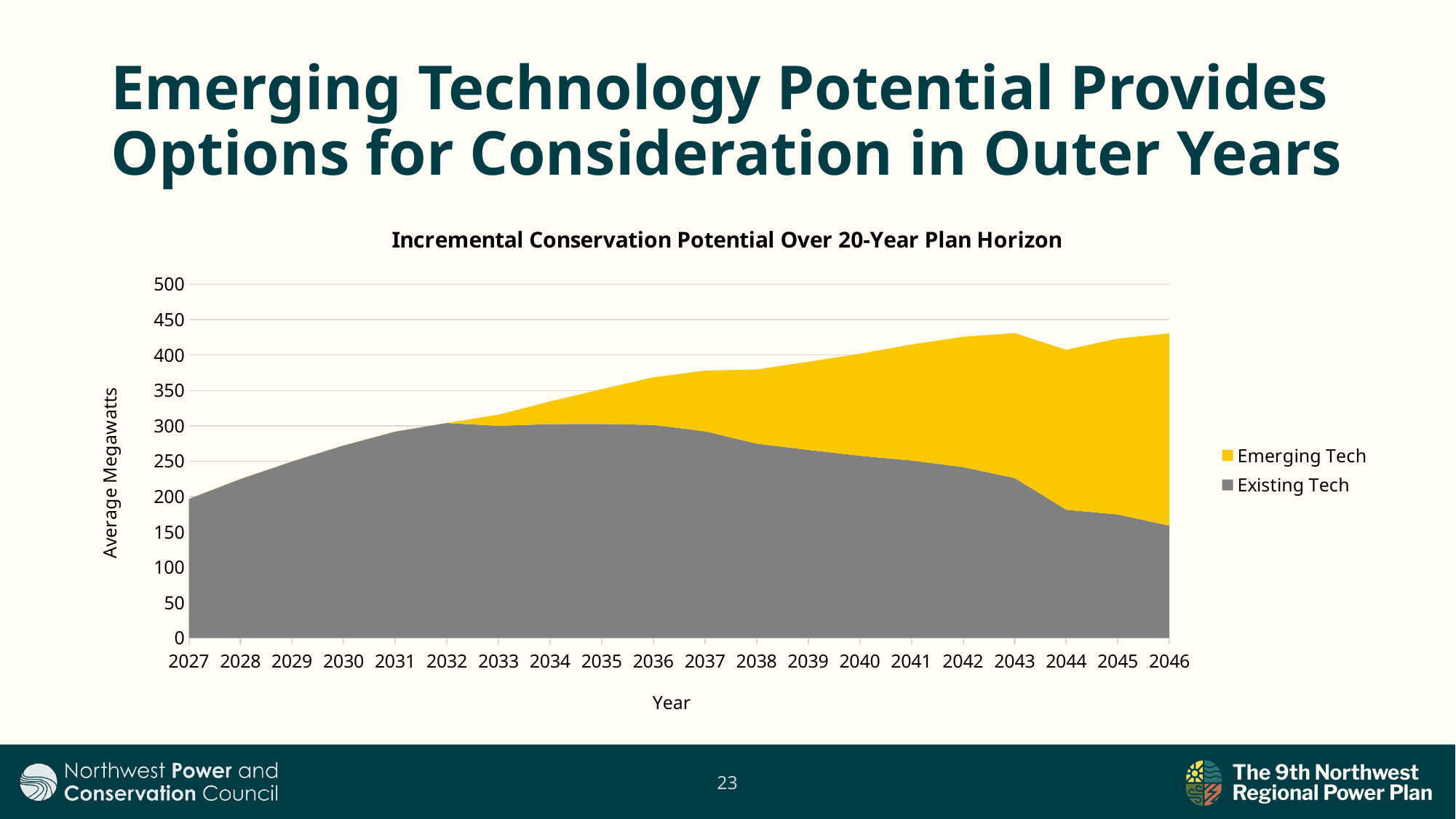
Which is larger, the Existing Tech value in 2030 or in 2046? 2030 Does the Existing Tech series rise or fall from 2036 to 2046? fall Is the value for Existing Tech in 2046 greater or less than 200? less How many years are shown along the x axis? 20 What is the label of the vertical axis? Average Megawatts How many series does the legend list? 2 Is the value for Existing Tech in 2035 greater or less than 250? greater Is the value for Existing Tech in 2043 greater or less than 250? less In which year is the Existing Tech value lowest? 2046 What is the title of the chart? Incremental Conservation Potential Over 20-Year Plan Horizon What type of chart is shown on the slide? Stacked area chart